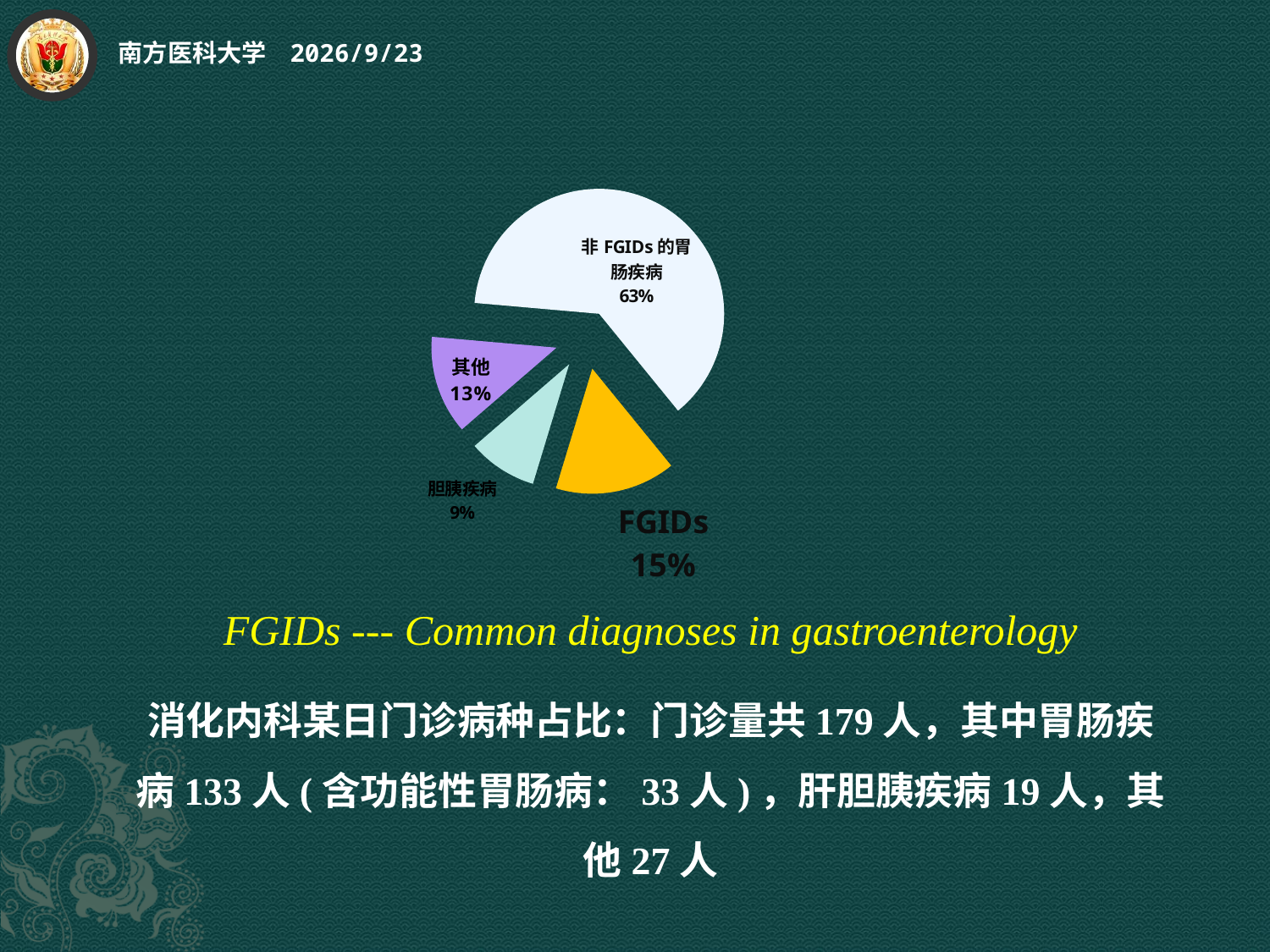
What is the difference in percentage points between the 其他 slice and the 胆胰疾病 slice? 4 What colour is the FGIDs slice in the pie chart? yellow Which slice of the pie chart is the smallest? 胆胰疾病 What kind of chart is shown on the slide? pie chart What share of the pie does the 胆胰疾病 slice represent? 9% What share of the pie does the FGIDs slice represent? 15% What share of the pie does the 非FGIDs的胃肠疾病 slice represent? 63% Which slice of the pie chart is the largest? 非FGIDs的胃肠疾病 Which is larger, the FGIDs slice or the 其他 slice? FGIDs How many slices does the pie chart have? 4 What is the difference in percentage points between the 非FGIDs的胃肠疾病 slice and the FGIDs slice? 48